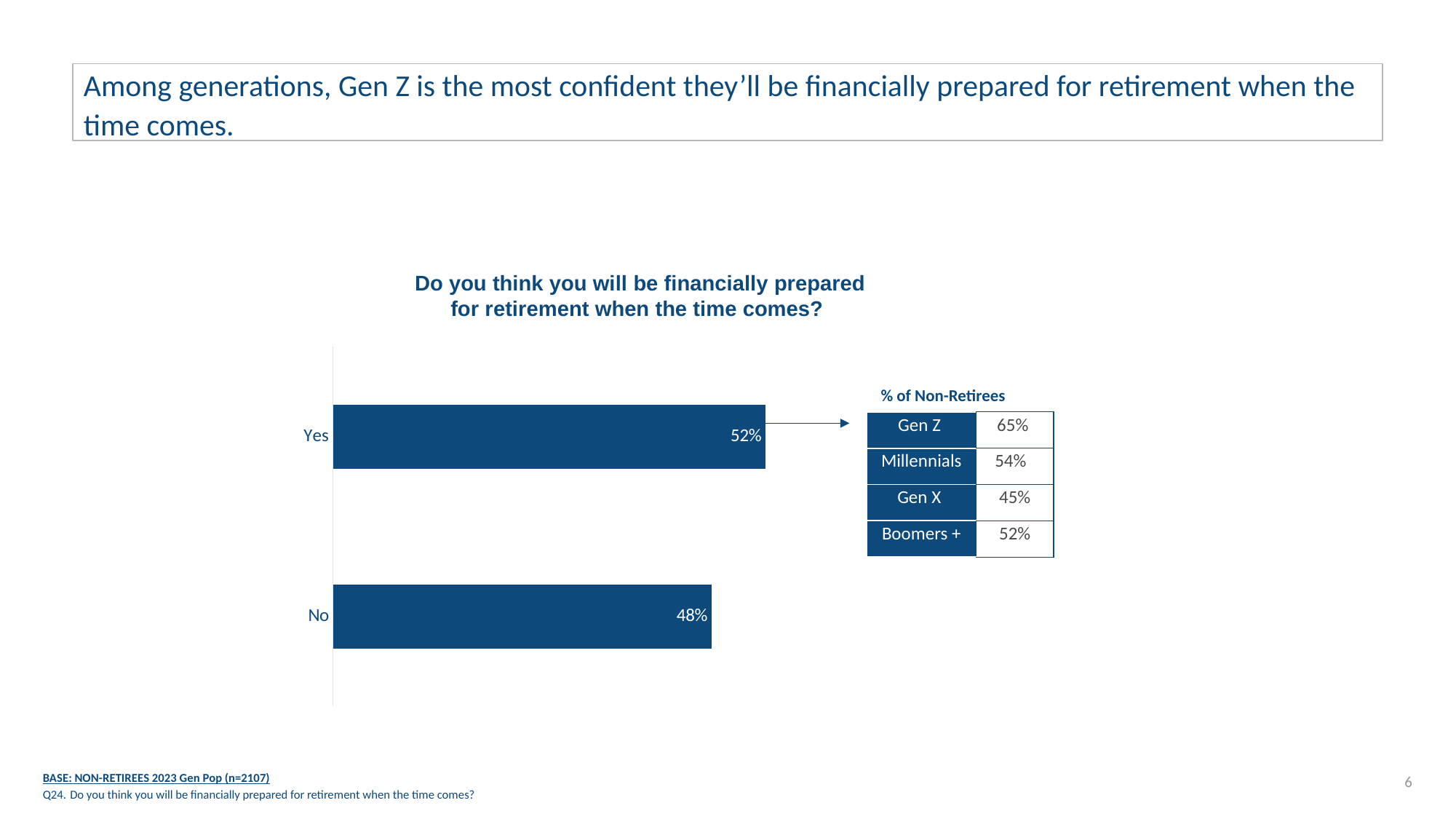
What percentage of respondents answered "No"? 48% What is the title of the chart? Do you think you will be financially prepared for retirement when the time comes? What is the difference in percentage points between the Yes and No responses? 4 percentage points In the % of Non-Retirees table, which generation has the lowest percentage? Gen X Which response, Yes or No, has the higher percentage? Yes In the % of Non-Retirees table, what is the difference between Gen Z and Millennials? 11 percentage points In the % of Non-Retirees table, is the value for Millennials or Boomers + larger? Millennials Which response has the lowest percentage? No In the % of Non-Retirees table, what percentage of Gen Z said Yes? 65% What percentage of respondents answered "Yes" to whether they think they will be financially prepared for retirement? 52% What type of chart is used to show the Yes and No responses? Bar chart How many response categories are shown in the bar chart? 2